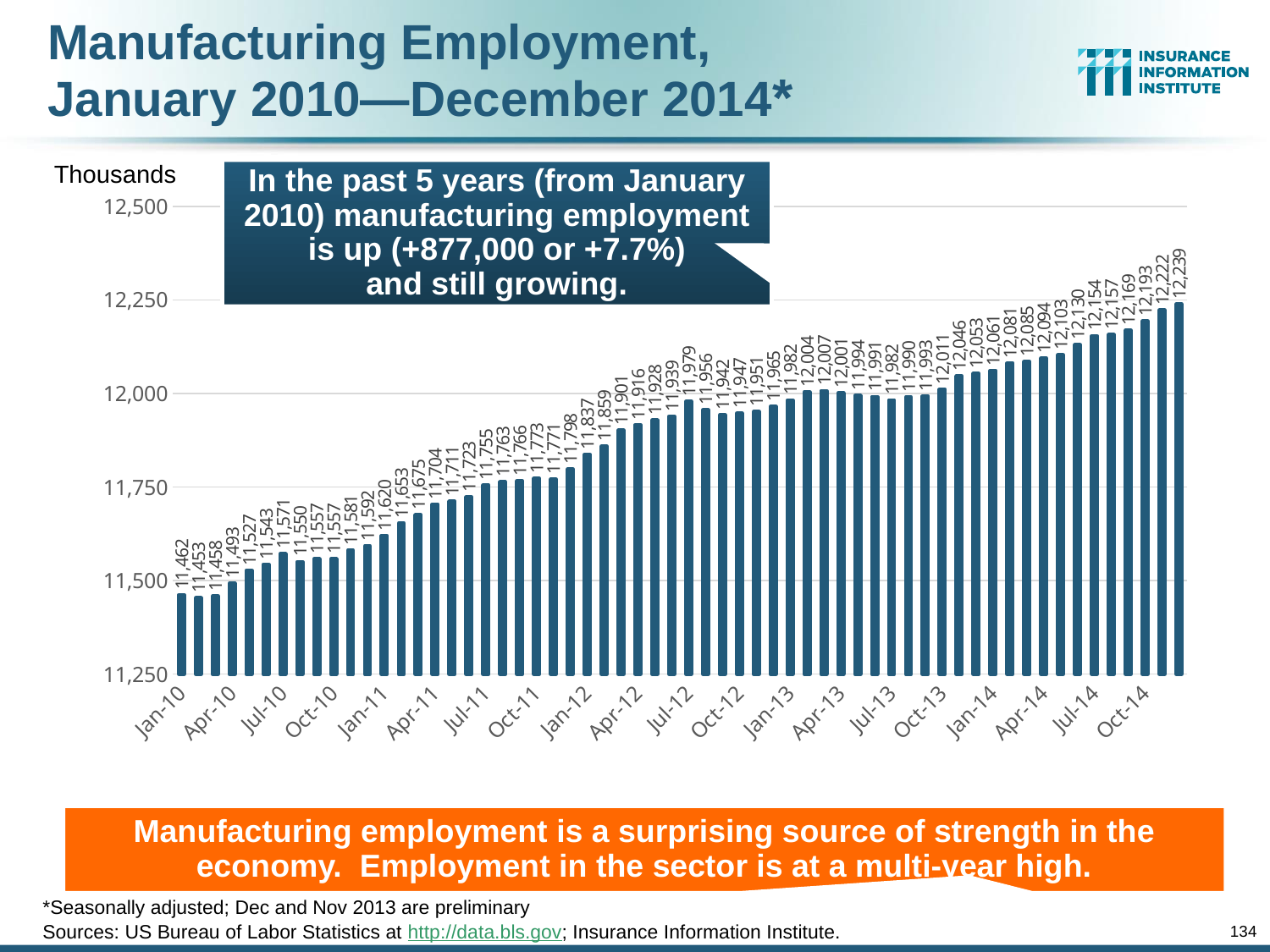
What is the manufacturing employment value for the last bar (December 2014)? 12,239 Which is larger, the value for Jan-11 or the value for Jan-12? Jan-12 What kind of chart is shown on the slide? bar chart What is the difference between the Jan-14 value and the Jan-13 value? 79 What is the lowest value shown on the chart? 11,453 What is the manufacturing employment value for Jan-14? 12,061 Is the value for Jan-12 greater or less than 11,750? greater What is the manufacturing employment value for Jan-10? 11,462 What is the manufacturing employment value for Jan-13? 11,982 Which month has the highest manufacturing employment value? Dec-14 Do the values generally rise or fall from Jan-10 to Dec-14? rise In what unit are the values on the y-axis expressed? Thousands